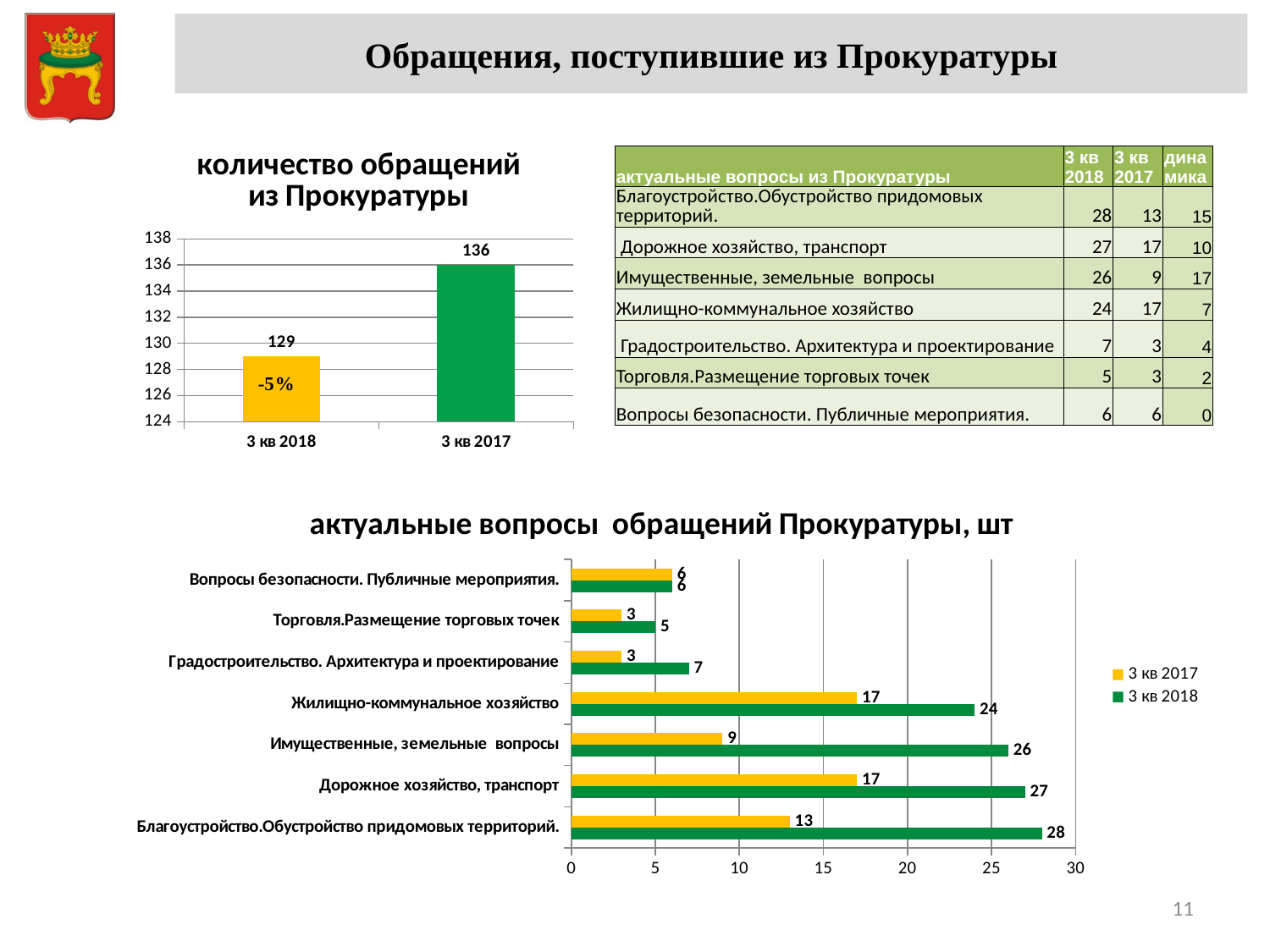
In the chart 'количество обращений из Прокуратуры', what is the value for 3 кв 2018? 129 In the chart 'количество обращений из Прокуратуры', what percentage change is printed on the 3 кв 2018 bar? -5% What type of chart is 'актуальные вопросы обращений Прокуратуры, шт'? Bar chart In the chart 'актуальные вопросы обращений Прокуратуры, шт', what is the 3 кв 2018 value for Имущественные, земельные вопросы? 26 In the chart 'актуальные вопросы обращений Прокуратуры, шт', which category has the highest 3 кв 2018 value? Благоустройство.Обустройство придомовых территорий. In the chart 'количество обращений из Прокуратуры', what is the value for 3 кв 2017? 136 In the chart 'количество обращений из Прокуратуры', what is the difference between the 3 кв 2017 and 3 кв 2018 values? 7 In the chart 'актуальные вопросы обращений Прокуратуры, шт', what is the 3 кв 2017 value for Жилищно-коммунальное хозяйство? 17 In the chart 'актуальные вопросы обращений Прокуратуры, шт', which category has the lowest 3 кв 2017 value? Торговля.Размещение торговых точек and Градостроительство. Архитектура и проектирование (both 3) In the chart 'актуальные вопросы обращений Прокуратуры, шт', how many categories are shown? 7 In the chart 'актуальные вопросы обращений Прокуратуры, шт', what is the difference between the 3 кв 2018 and 3 кв 2017 values for Дорожное хозяйство, транспорт? 10 In the chart 'актуальные вопросы обращений Прокуратуры, шт', how many series does the legend list? 2